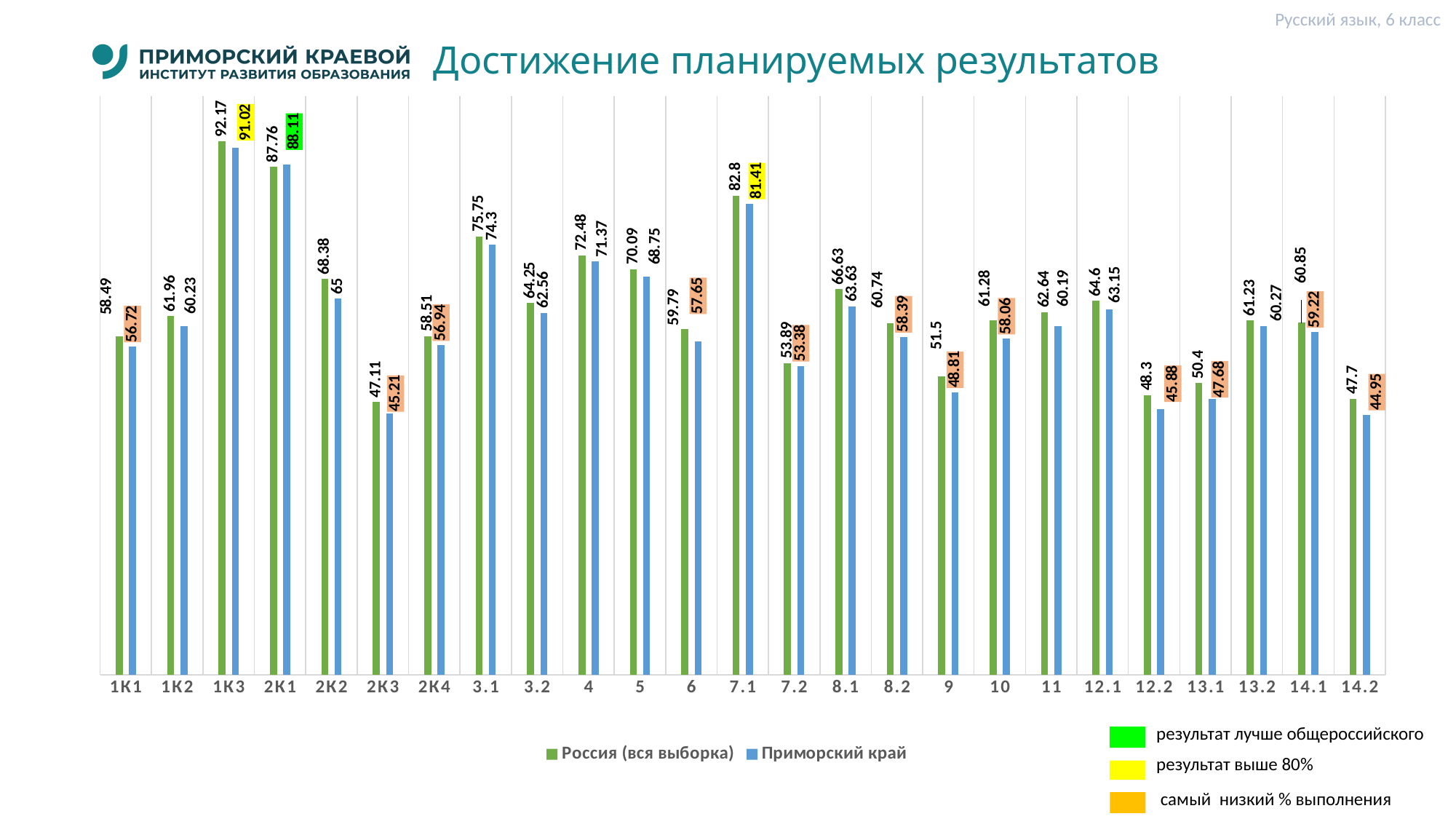
What is the value for Приморский край in category 1К3? 91.02 What kind of chart is shown on the slide? bar chart What is the value for Приморский край in category 14.2? 44.95 What is the difference between Россия (вся выборка) and Приморский край in category 8.1? 3 Which category has the lowest value for Приморский край? 14.2 Which category has the highest value for Приморский край? 1К3 How many series does the legend list? 2 What is the title of the chart? Достижение планируемых результатов Which category has the lowest value for Россия (вся выборка)? 2К3 How many categories are shown on the x axis? 25 In category 2К1, which series has the larger value: Россия (вся выборка) or Приморский край? Приморский край What is the value for Россия (вся выборка) in category 7.1? 82.8